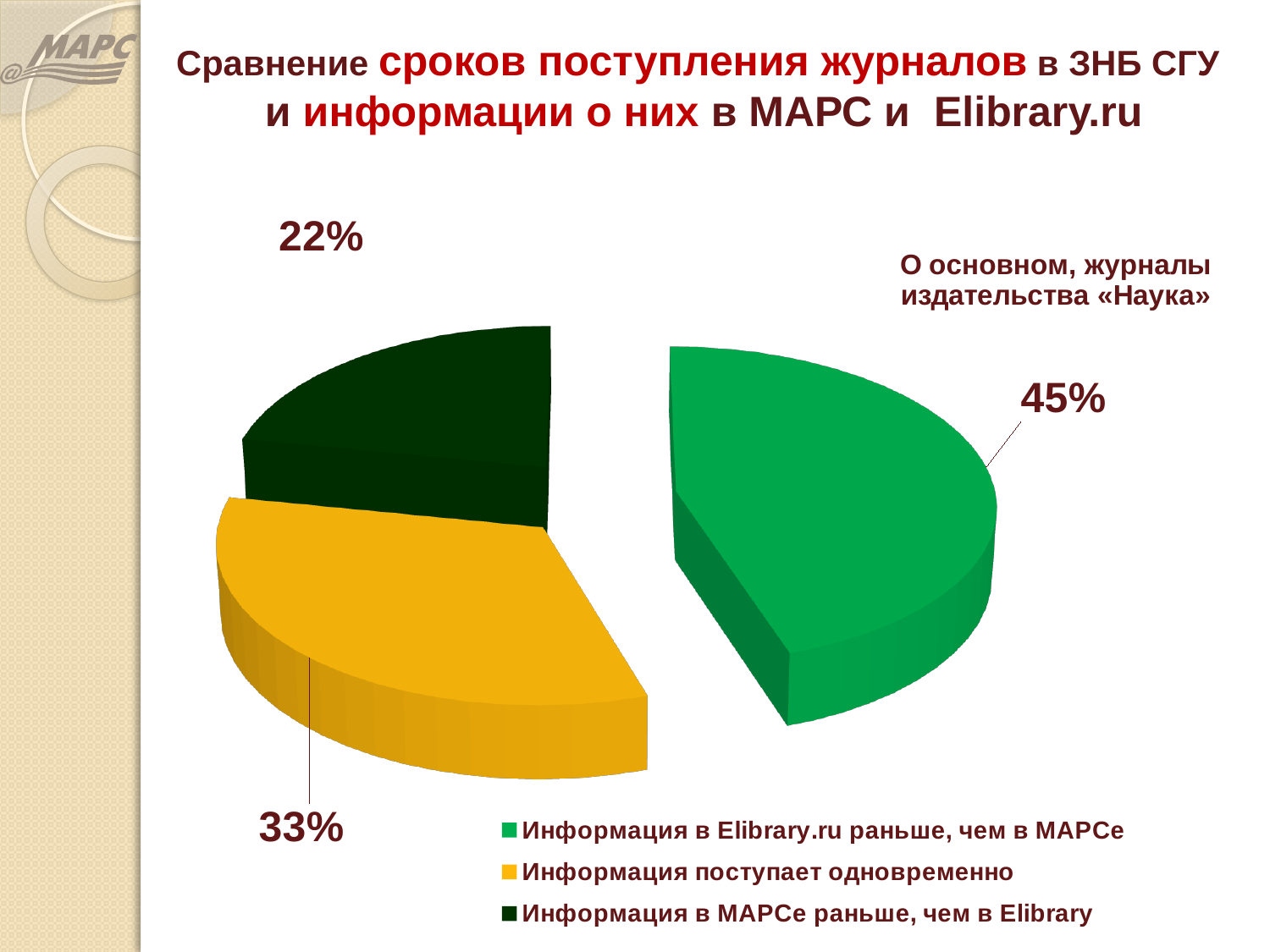
What kind of chart is shown on the slide? Pie chart What colour is the slice representing "Информация поступает одновременно"? Yellow What is the difference in percentage points between the "Информация в Elibrary.ru раньше, чем в МАРСе" slice and the "Информация поступает одновременно" slice? 12 percentage points What share of the pie is labelled "Информация в МАРСе раньше, чем в Elibrary"? 22% How many slices does the pie chart have? 3 What share of the pie is labelled "Информация в Elibrary.ru раньше, чем в МАРСе"? 45% Which category has the smallest slice of the pie? Информация в МАРСе раньше, чем в Elibrary What share of the pie is labelled "Информация поступает одновременно"? 33% Which is larger: the "Информация поступает одновременно" slice or the "Информация в МАРСе раньше, чем в Elibrary" slice? Информация поступает одновременно Which category has the largest slice of the pie? Информация в Elibrary.ru раньше, чем в МАРСе What is the difference in percentage points between the "Информация в Elibrary.ru раньше, чем в МАРСе" slice and the "Информация в МАРСе раньше, чем в Elibrary" slice? 23 percentage points How many entries does the legend list? 3